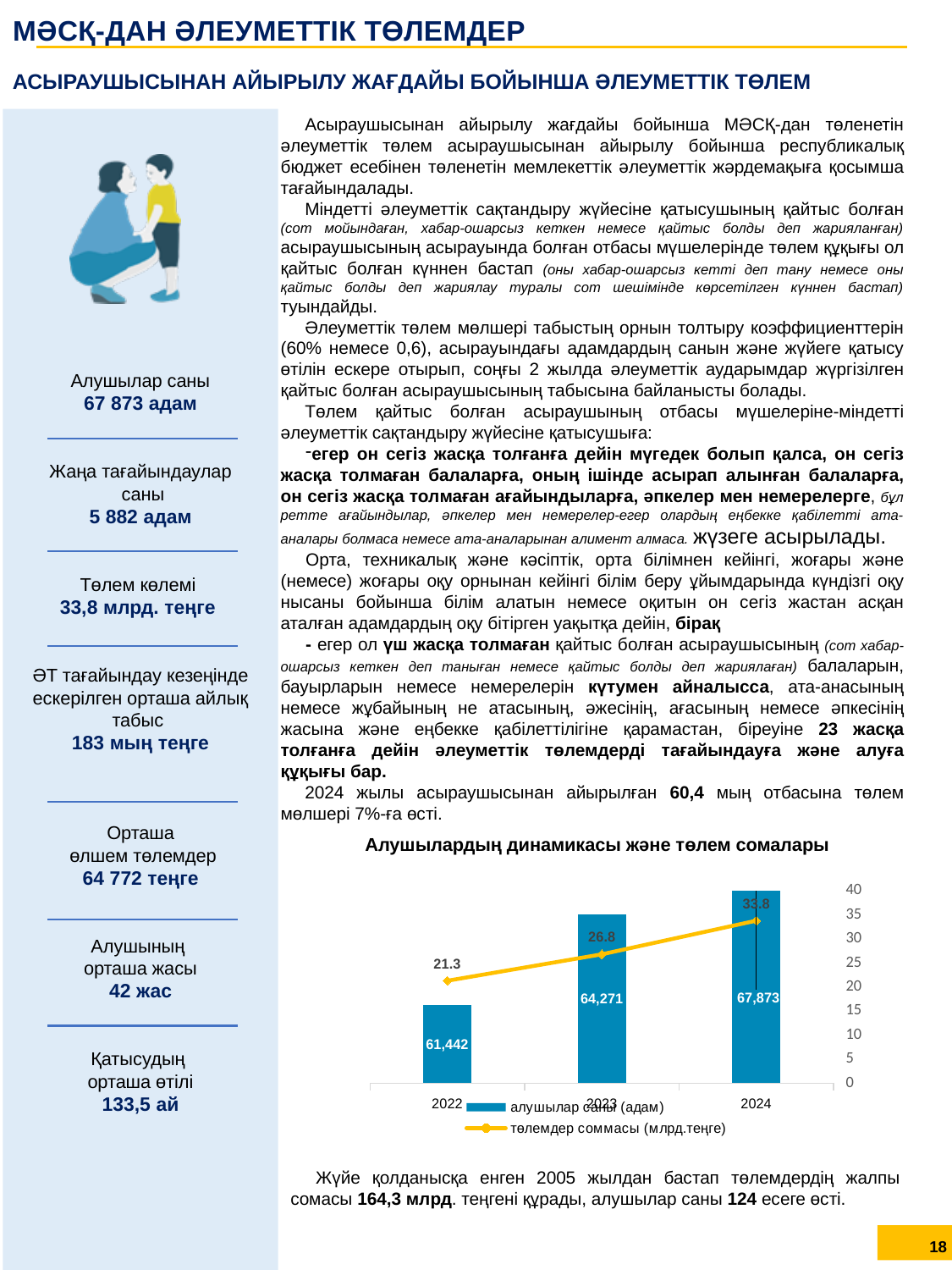
Which year has the lowest value for алушылар саны (адам)? 2022 What is the value of алушылар саны (адам) for 2024? 67,873 How many series does the chart legend list? 2 What is the title of the chart on the slide? Алушылардың динамикасы және төлем сомалары What is the difference between the алушылар саны (адам) values for 2024 and 2023? 3,602 What is the value of төлемдер соммасы (млрд.теңге) for 2023? 26.8 How many years are shown on the x axis of the chart? 3 Which year has the highest value for төлемдер соммасы (млрд.теңге)? 2024 Do the төлемдер соммасы (млрд.теңге) values rise or fall from 2022 to 2024? Rise What is the value of төлемдер соммасы (млрд.теңге) for 2022? 21.3 What is the value of алушылар саны (адам) for 2022? 61,442 What type of chart is shown on the slide? Combined bar and line chart